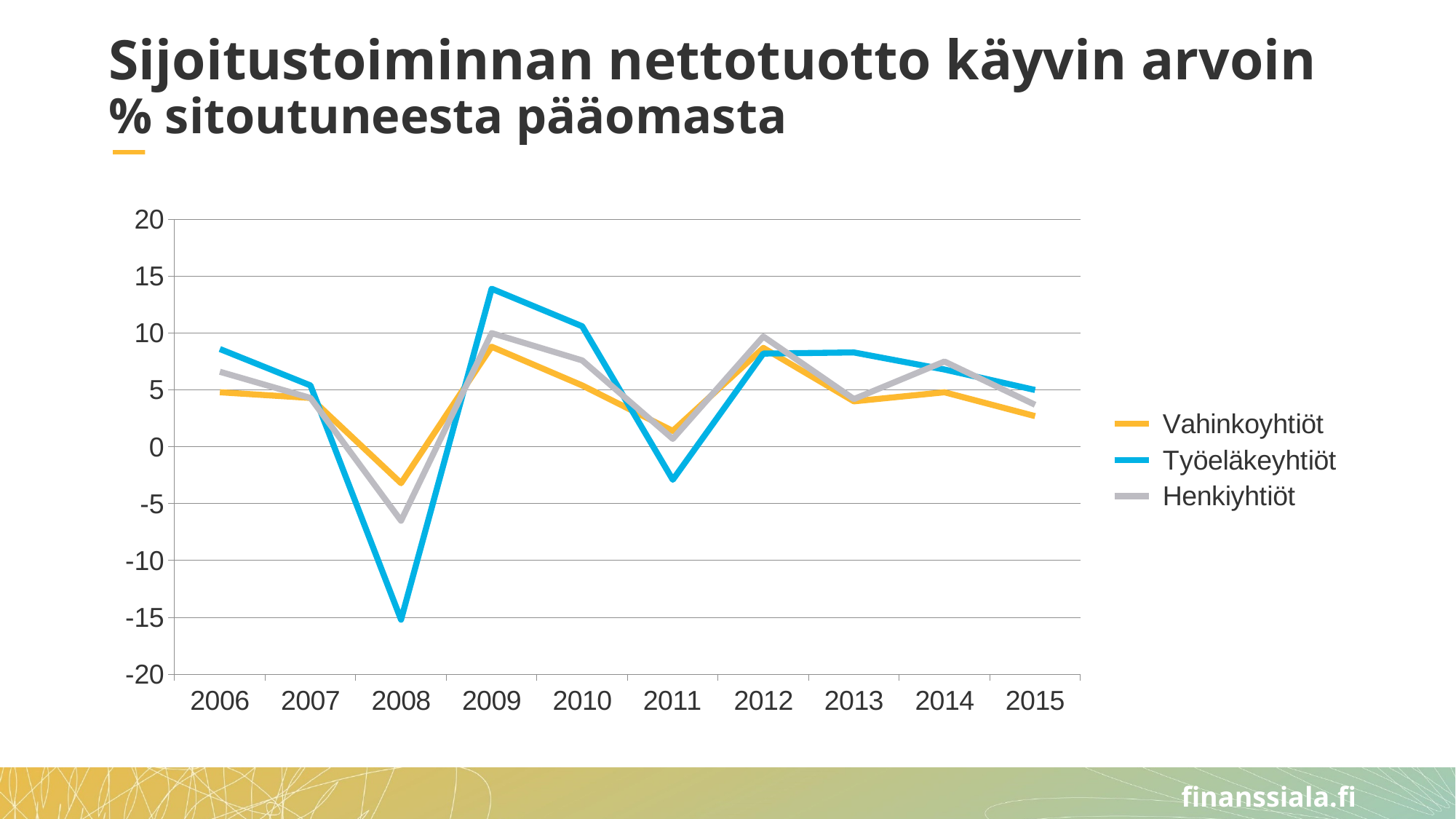
In which year is the value for Työeläkeyhtiöt highest? 2009 What kind of chart is shown on the slide? line chart Is the value for Vahinkoyhtiöt in 2008 greater or less than -5? greater How many series does the legend list? 3 Which series has the lowest value in 2008? Työeläkeyhtiöt Does the value for Vahinkoyhtiöt rise or fall from 2014 to 2015? fall In 2010, which is larger: Työeläkeyhtiöt or Vahinkoyhtiöt? Työeläkeyhtiöt Is the value for Työeläkeyhtiöt in 2009 greater or less than 10? greater In which year is the value for Työeläkeyhtiöt lowest? 2008 Is the value for Työeläkeyhtiöt in 2008 greater or less than -10? less How many years are shown on the x axis? 10 What colour is the line for Henkiyhtiöt? grey